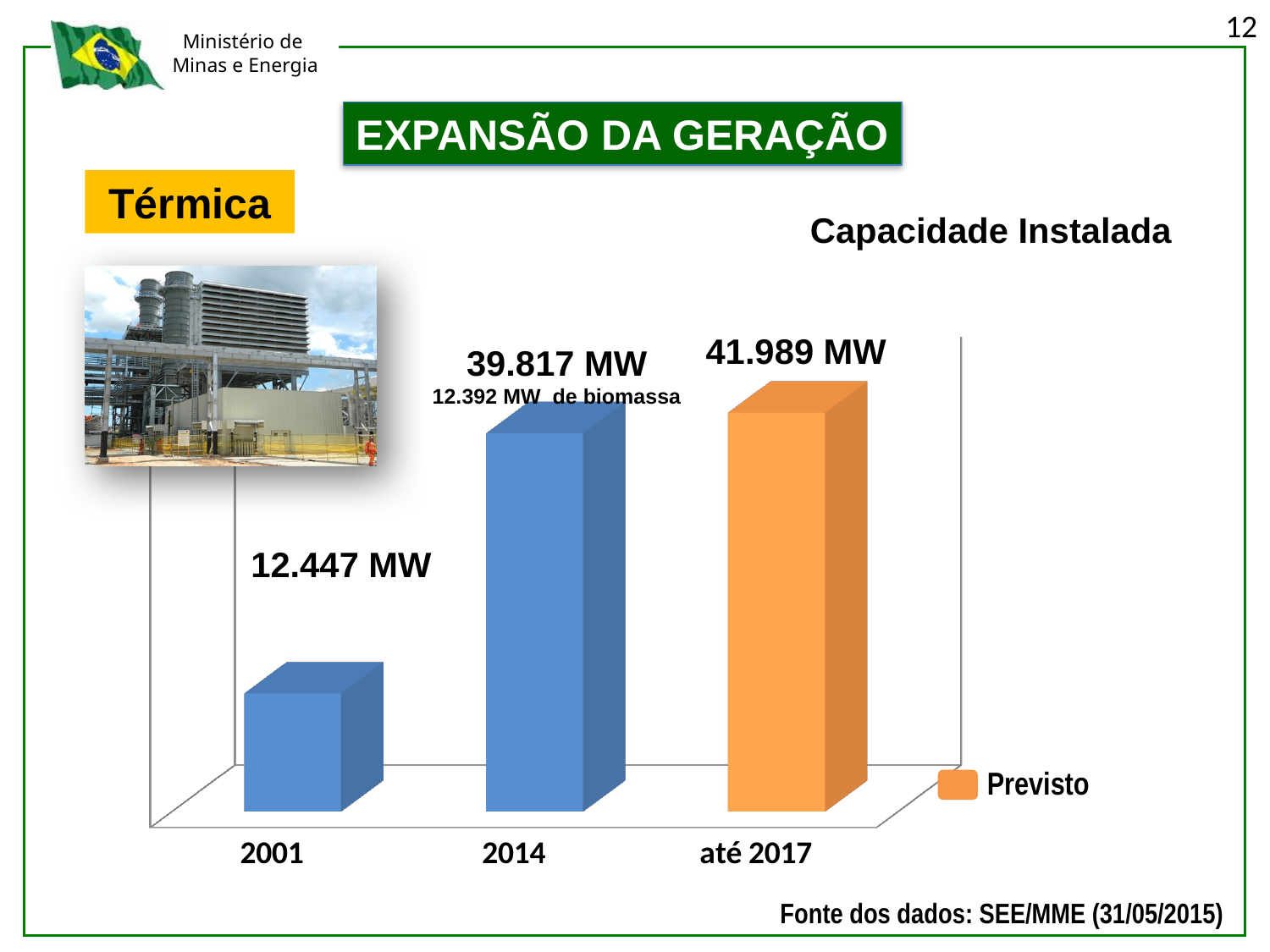
Which category has the highest installed capacity? até 2017 What is the installed capacity shown for 'até 2017'? 41.989 MW Which category has the lowest installed capacity? 2001 What is the only entry listed in the chart's legend? Previsto What is the difference between the capacity for 'até 2017' and the capacity for 2014? 2.172 MW Which is larger, the capacity for 2001 or the capacity for 2014? 2014 What is the installed capacity shown for 2001? 12.447 MW What is the difference between the capacity for 2014 and the capacity for 2001? 27.370 MW What kind of chart is shown on the slide? Bar chart What is the installed capacity shown for 2014? 39.817 MW How much of the 2014 capacity is from biomass, according to the label on the chart? 12.392 MW How many categories are shown on the x axis of the chart? 3